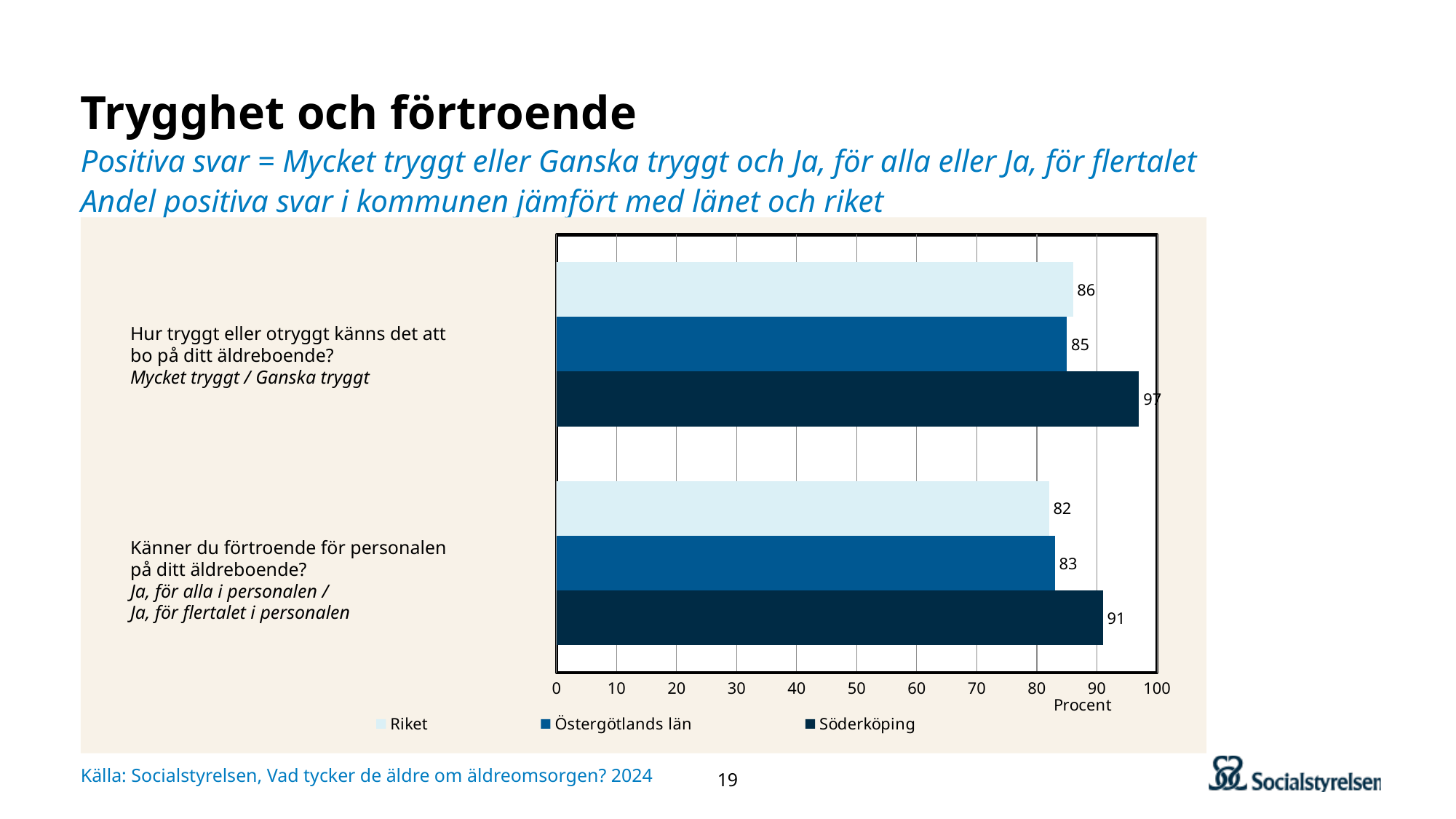
What is the difference between Söderköping and Riket on the question "Hur tryggt eller otryggt känns det att bo på ditt äldreboende?"? 11 What kind of chart is shown on the slide? Bar chart What unit is shown on the x axis of the chart? Procent What is the difference between Söderköping and Östergötlands län on the question "Känner du förtroende för personalen på ditt äldreboende?"? 8 Which series has the highest value on the question "Känner du förtroende för personalen på ditt äldreboende?"? Söderköping What is the value for Riket on the question "Känner du förtroende för personalen på ditt äldreboende?"? 82 What is the value for Östergötlands län on the question "Hur tryggt eller otryggt känns det att bo på ditt äldreboende?"? 85 Which series has the lowest value on the question "Hur tryggt eller otryggt känns det att bo på ditt äldreboende?"? Östergötlands län Which is larger: Söderköping's value for the trygghet question or Söderköping's value for the förtroende question? The trygghet question (97) How many series does the legend list? 3 What is the value for Östergötlands län on the question "Känner du förtroende för personalen på ditt äldreboende?"? 83 What is the value for Söderköping on the question "Hur tryggt eller otryggt känns det att bo på ditt äldreboende?"? 97